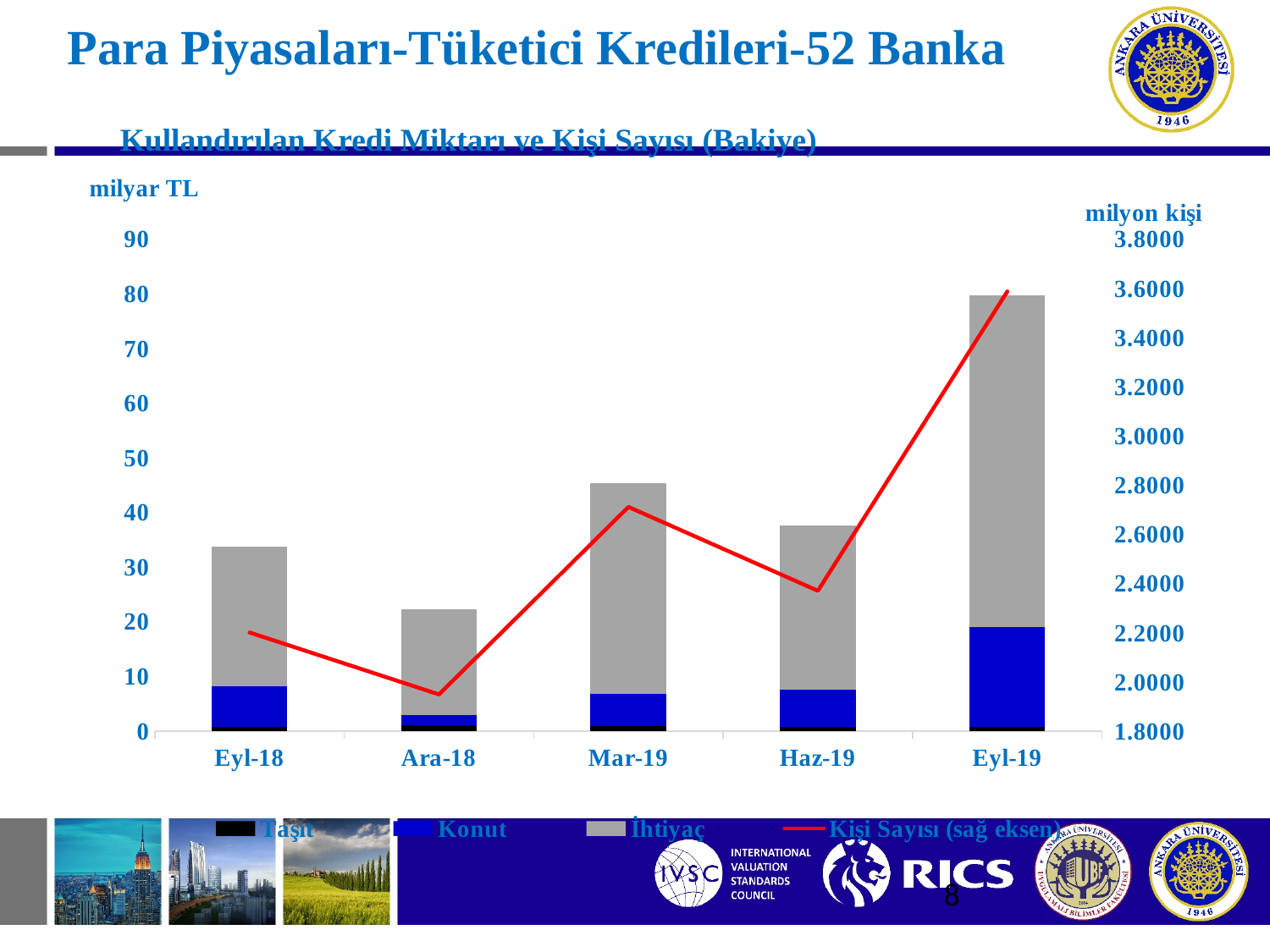
Which has the taller stacked bar, Mar-19 or Haz-19? Mar-19 Which period has the shortest stacked bar? Ara-18 How many time periods are shown on the x axis of the chart? 5 Which period has the tallest stacked bar? Eyl-19 Is the Kişi Sayısı value for Eyl-19 greater or less than 3.4000 milyon kişi? greater Is the Kişi Sayısı value for Ara-18 greater or less than 2.2000 milyon kişi? less How many series does the chart's legend list? 4 What is the unit shown for the right-hand axis of the chart? milyon kişi Is the total stacked bar for Ara-18 greater or less than 30 milyar TL? less What kind of chart is shown on the slide? Stacked bar chart with a line Does the Kişi Sayısı line rise or fall from Haz-19 to Eyl-19? rise